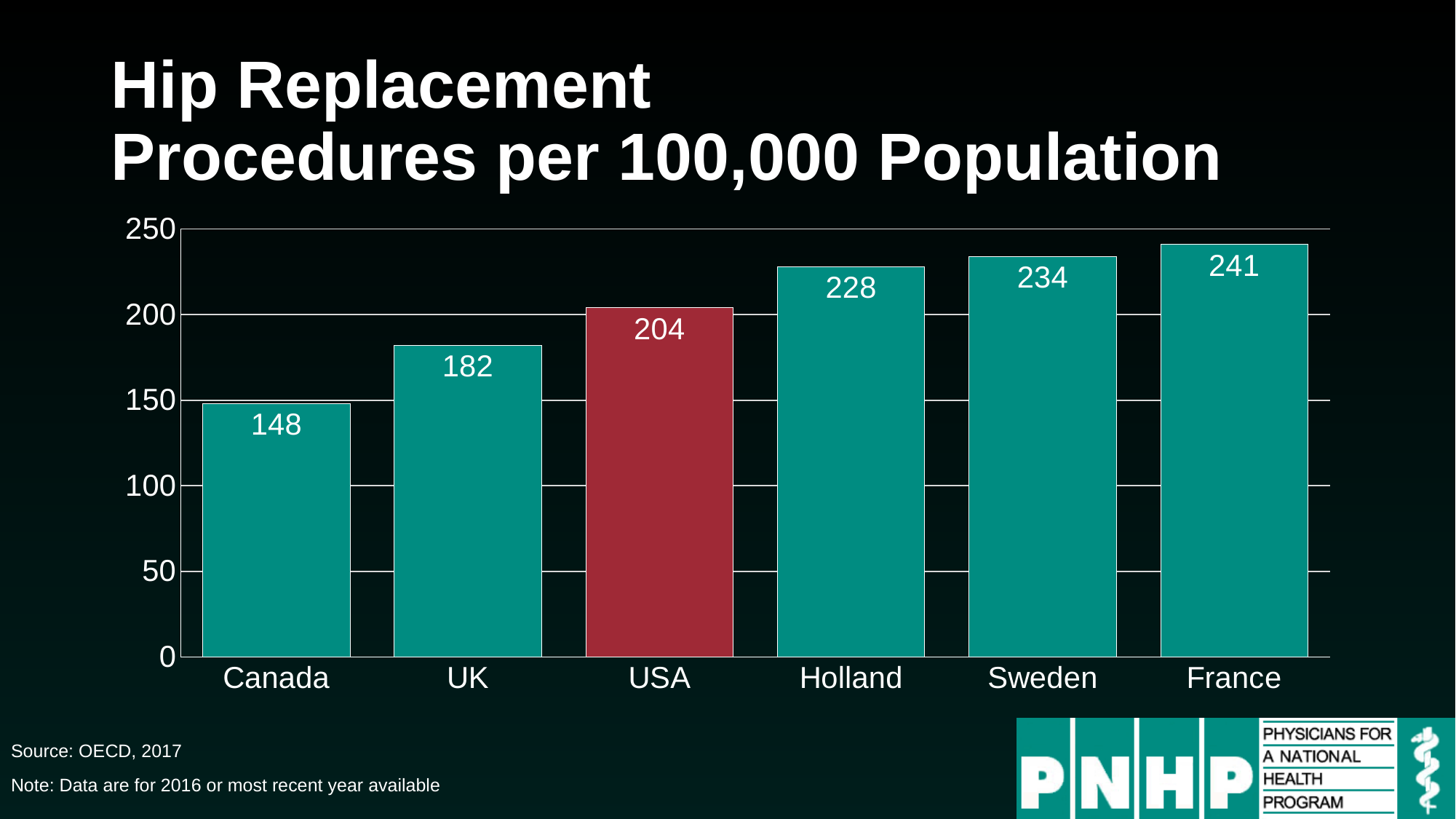
What is the difference between the values for France and Canada? 93 What kind of chart is shown on the slide? bar chart What is the value for Canada? 148 What is the value for the USA? 204 Which country's bar is coloured differently (red) from the others? USA What is the difference between the values for Holland and the USA? 24 Which country has the highest number of hip replacement procedures per 100,000 population? France What is the value for Sweden? 234 Which country has the lowest number of hip replacement procedures per 100,000 population? Canada Which has a higher value, the UK or Holland? Holland Is the value for the UK greater or less than 200? less How many countries are shown in the chart? 6